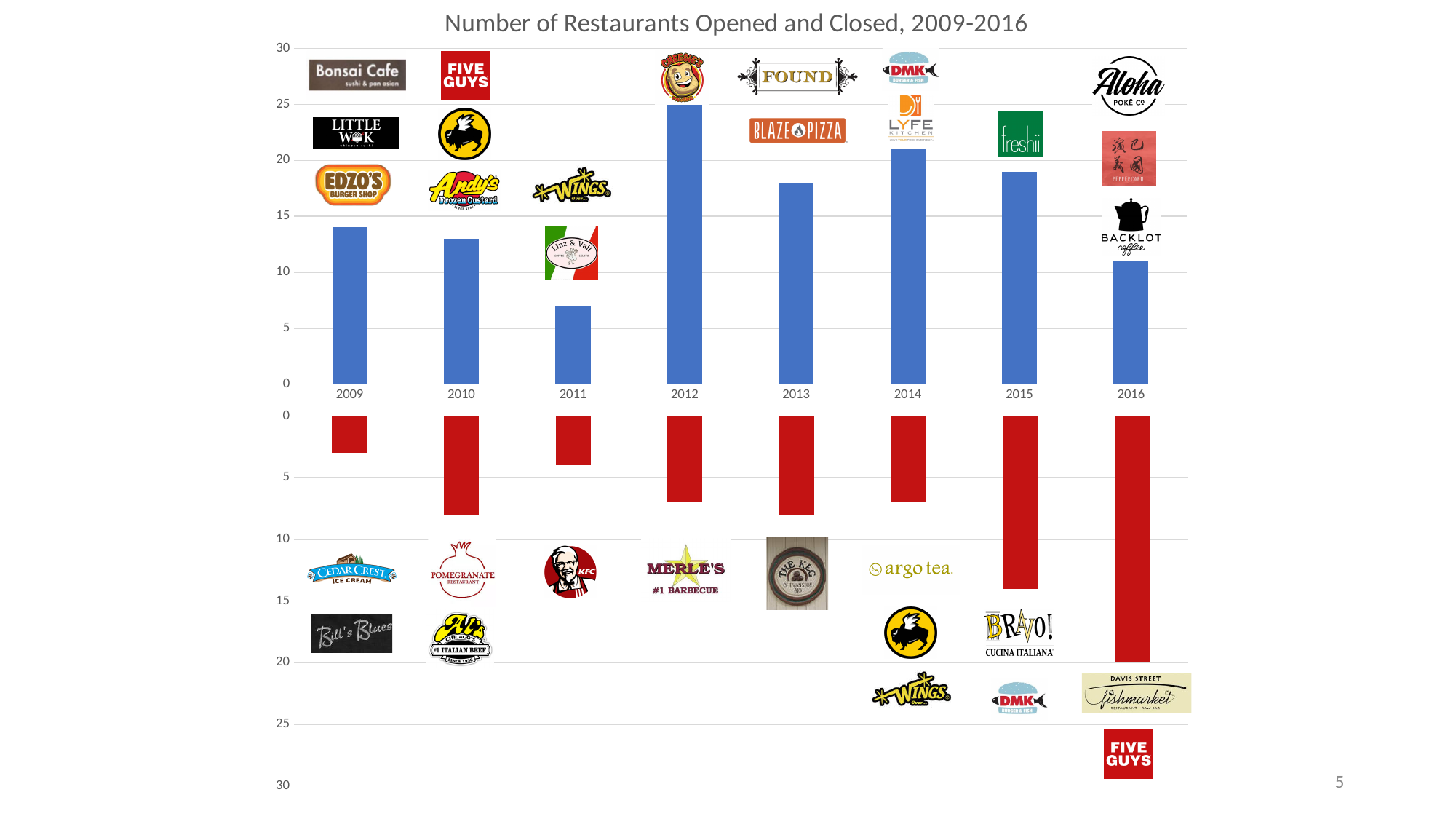
In the bottom (red, closed) chart, which year has the highest number of restaurants closed? 2016 In the top (blue, opened) chart, which year has the highest number of restaurants opened? 2012 In the bottom (red, closed) chart, is the value for 2015 greater or less than 10? greater In the bottom (red, closed) chart, how many restaurants closed in 2016? 20 What kind of chart is used to show the number of restaurants opened and closed? bar chart In the top (blue, opened) chart, which year has the lowest number of restaurants opened? 2011 What is the title of the chart on the slide? Number of Restaurants Opened and Closed, 2009-2016 In the top (blue, opened) chart, which year has the larger value, 2014 or 2015? 2014 In the bottom (red, closed) chart, is the value for 2009 greater or less than 5? less In the top (blue, opened) chart, how many restaurants opened in 2012? 25 How many years are shown on the x axis of the chart? 8 In the top (blue, opened) chart, is the value for 2013 greater or less than 15? greater